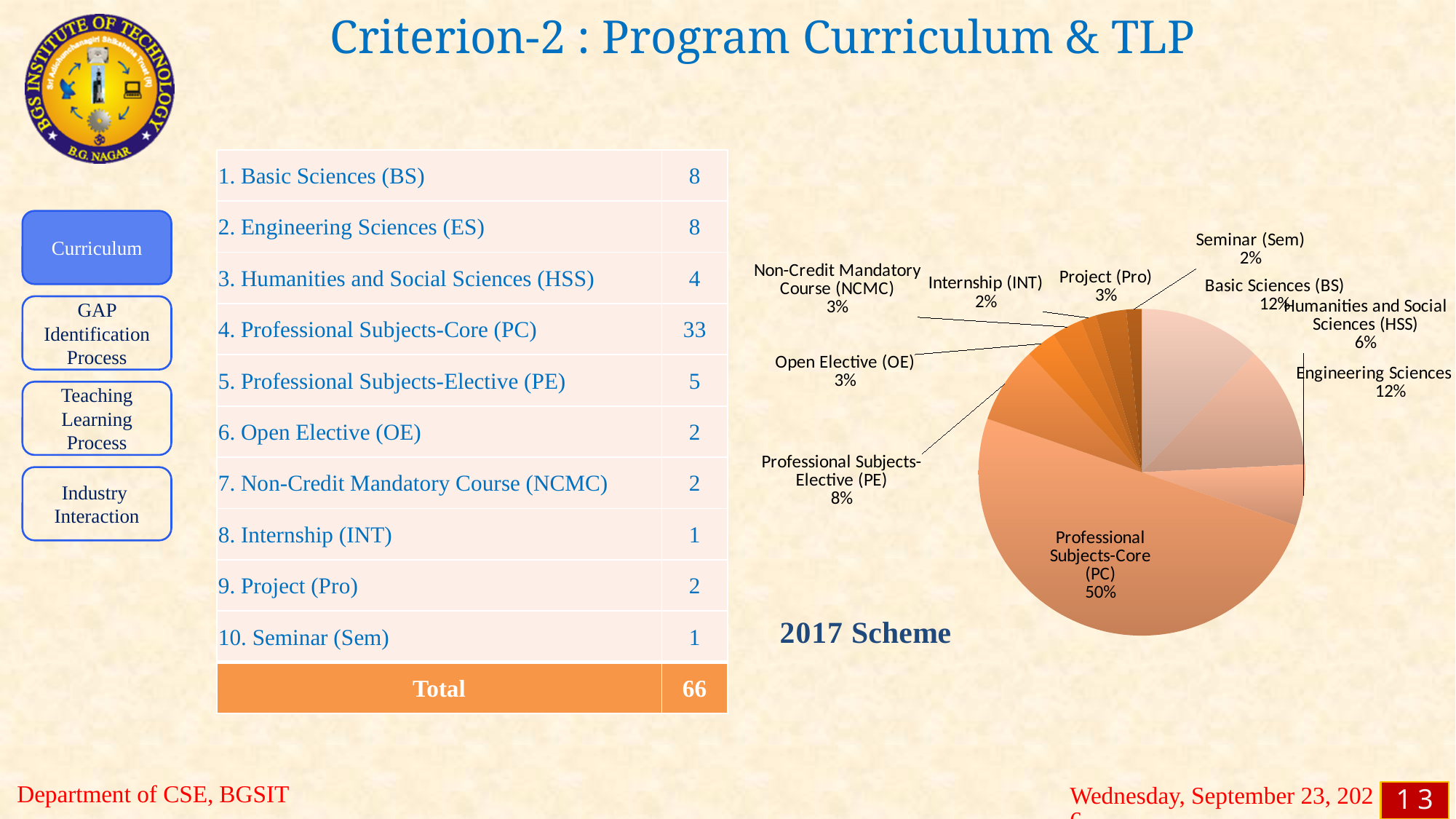
What percentage is shown for Internship (INT) in the pie chart? 2% What is the difference in percentage points between Professional Subjects-Core (PC) and Professional Subjects-Elective (PE) in the pie chart? 42 percentage points What share of the pie chart does Professional Subjects-Core (PC) represent? 50% How many slices does the pie chart have? 10 What percentage is shown for Professional Subjects-Elective (PE) in the pie chart? 8% Which category has the largest slice in the pie chart? Professional Subjects-Core (PC) What scheme label is printed next to the pie chart? 2017 Scheme What percentage is shown for Open Elective (OE) in the pie chart? 3% Which has a larger share in the pie chart, Professional Subjects-Elective (PE) or Humanities and Social Sciences (HSS)? Professional Subjects-Elective (PE) What type of chart is shown on the slide? Pie chart What percentage is shown for Humanities and Social Sciences (HSS) in the pie chart? 6% Which has a larger share in the pie chart, Basic Sciences (BS) or Project (Pro)? Basic Sciences (BS)